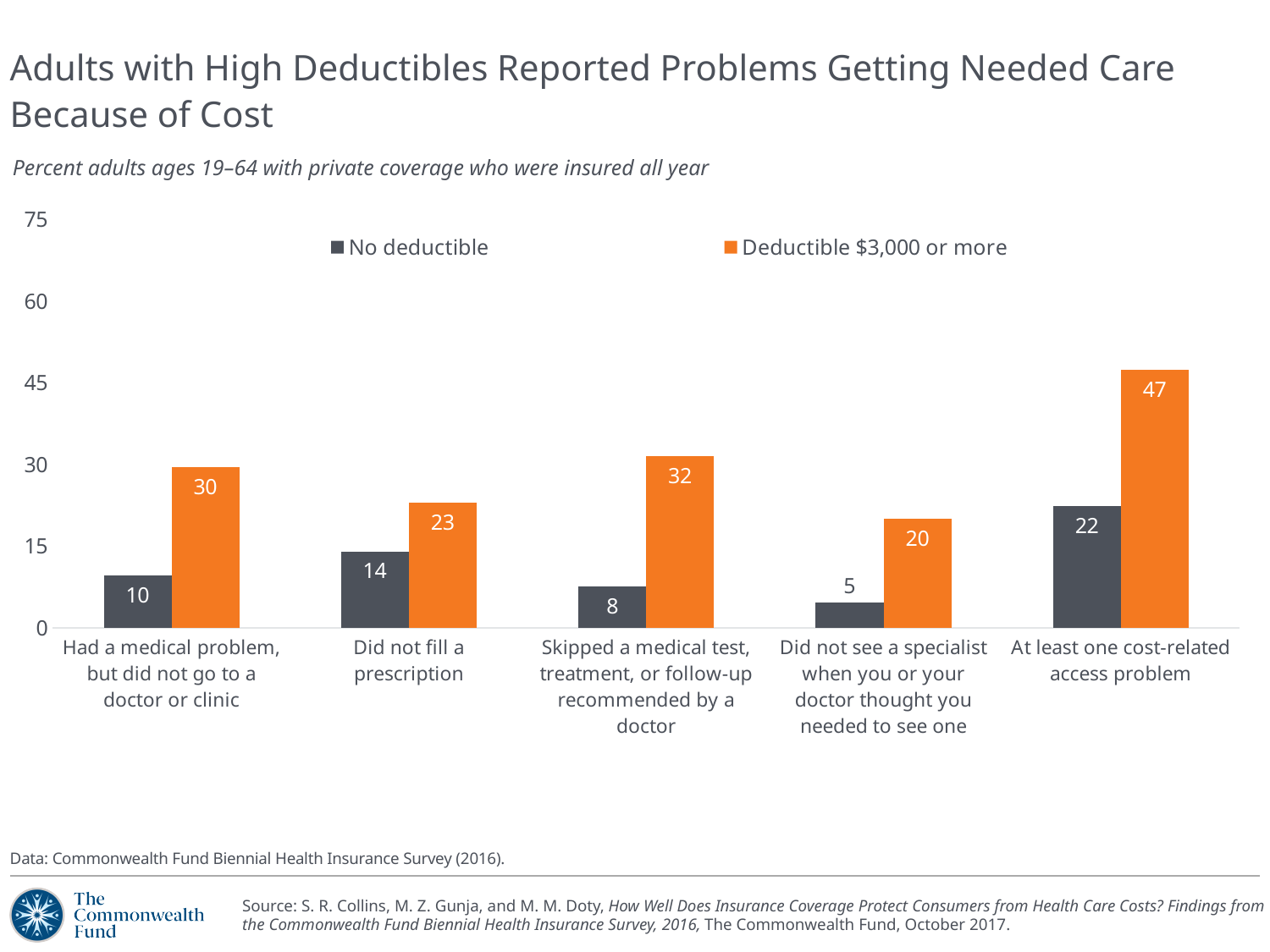
How many categories are shown on the x axis? 5 Which is larger: the "No deductible" value for "Did not fill a prescription" or the "No deductible" value for "Did not see a specialist when you or your doctor thought you needed to see one"? Did not fill a prescription What is the value for "Deductible $3,000 or more" in the "At least one cost-related access problem" category? 47 Which category has the lowest value for "Deductible $3,000 or more"? Did not see a specialist when you or your doctor thought you needed to see one Which category has the highest value for "No deductible"? At least one cost-related access problem How many series does the legend list? 2 What colour represents the "Deductible $3,000 or more" series? Orange What kind of chart is shown on the slide? Bar chart What is the difference between the "Deductible $3,000 or more" and "No deductible" values for "Had a medical problem, but did not go to a doctor or clinic"? 20 What is the value for "Deductible $3,000 or more" in the "Did not fill a prescription" category? 23 Is the value for "Deductible $3,000 or more" in "Skipped a medical test, treatment, or follow-up recommended by a doctor" greater or less than 30? greater What is the value for "No deductible" in the "Skipped a medical test, treatment, or follow-up recommended by a doctor" category? 8